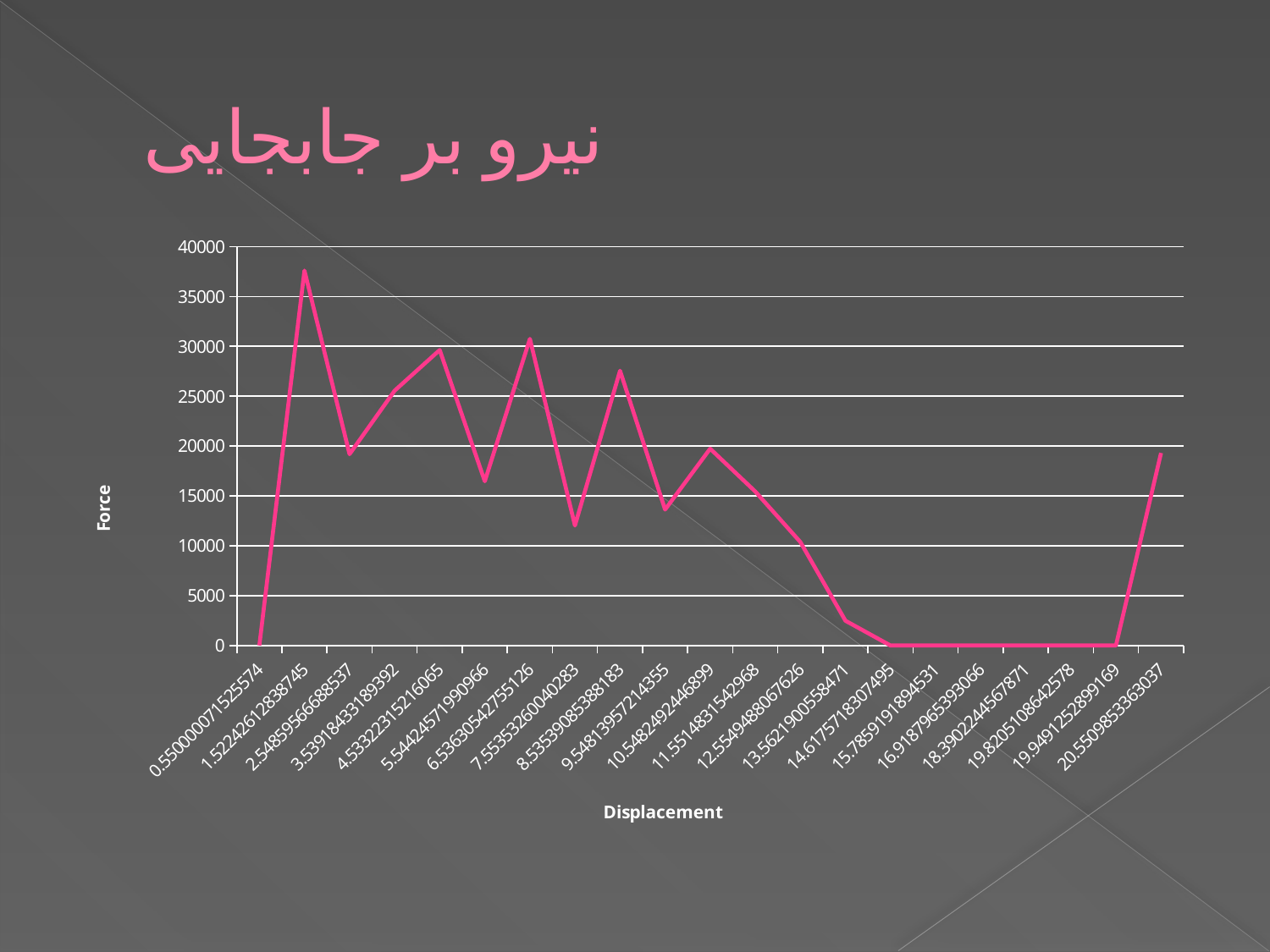
Is the force at displacement 8.53539085388183 greater or less than 15000? greater Is the force at displacement 4.53322315216065 greater or less than 25000? greater Which has the larger force: displacement 1.52242612838745 or displacement 4.53322315216065? 1.52242612838745 At which displacement value does the force reach its highest point? 1.52242612838745 How many data points are plotted on the line? 21 Is the force at displacement 1.52242612838745 greater or less than 35000? greater What is the title of the y axis of the chart? Force What kind of chart is shown on the slide? line chart What is the title of the x axis of the chart? Displacement Does the force rise or fall between displacement 11.5514831542968 and displacement 15.7859191894531? fall